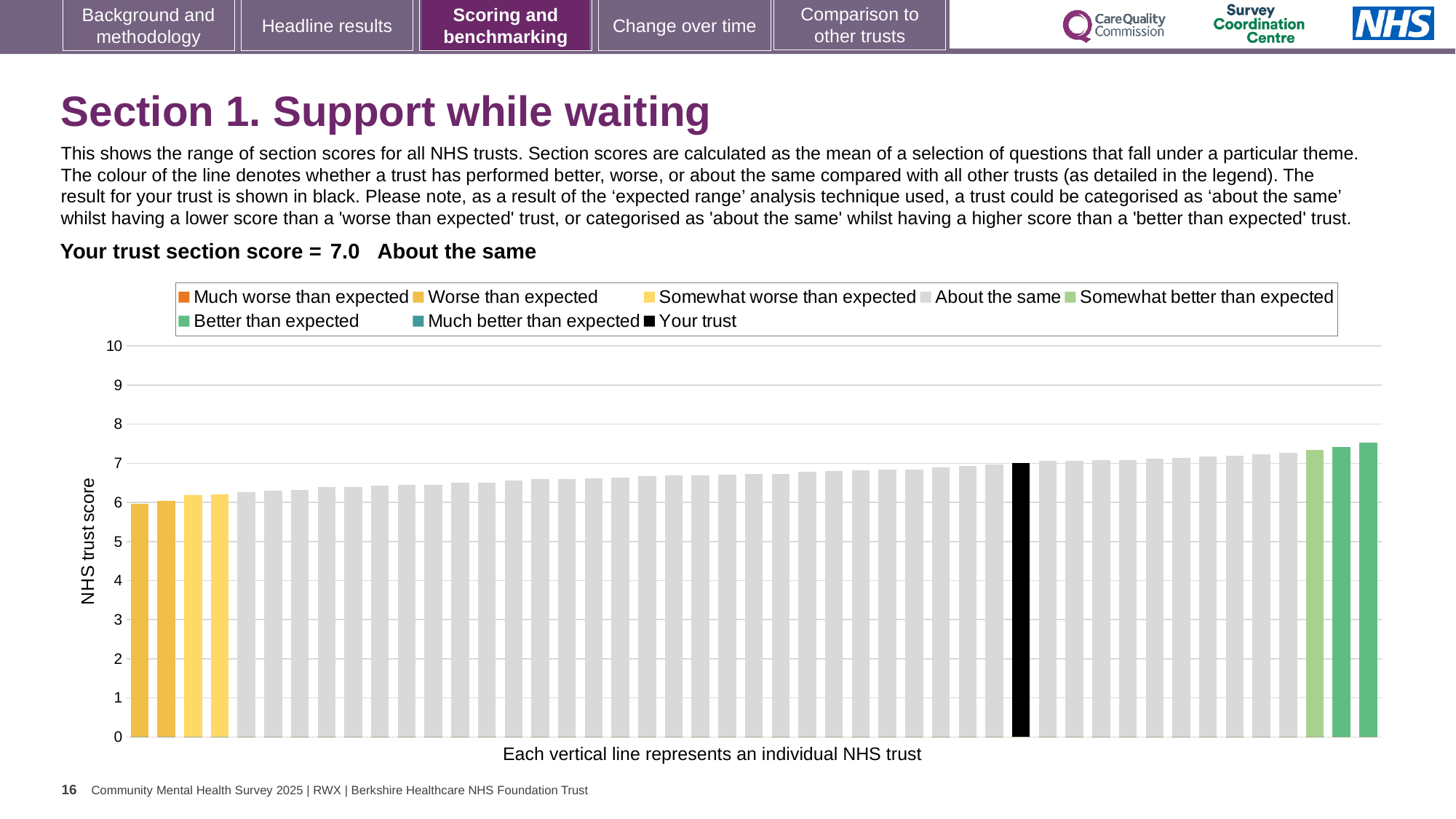
How many entries does the chart legend list? 8 What kind of chart is shown on the slide? bar chart Which legend category does the lowest-scoring trust belong to? Worse than expected Which legend category does the highest-scoring trust belong to? Better than expected Do the bar values rise or fall from left to right along the x axis? rise What is the label on the y axis of the chart? NHS trust score Is the value of the highest bar greater or less than 8? less Is the value of the black 'Your trust' bar greater or less than 5? greater Is the value of the leftmost bar greater or less than 7? less How many bars are coloured as 'Better than expected'? 2 Which is larger, the rightmost bar or the leftmost bar? the rightmost bar What is the section score for your trust shown on the slide? 7.0